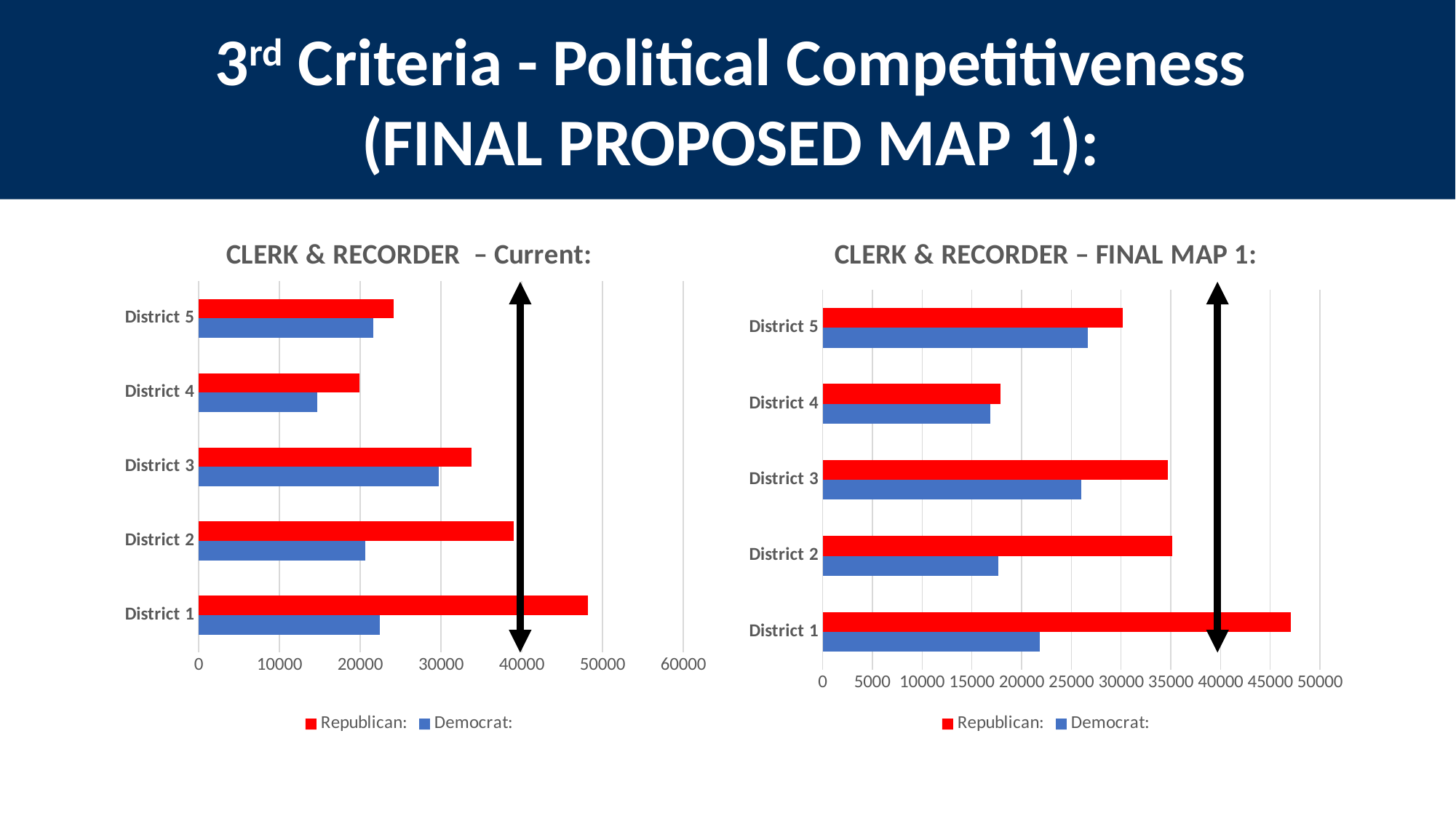
In the CLERK & RECORDER – Current chart, is the Republican value for District 1 greater or less than 40000? greater In the CLERK & RECORDER – FINAL MAP 1 chart, is the Democrat value for District 1 greater or less than 20000? greater In the CLERK & RECORDER – FINAL MAP 1 chart, which district has the highest Republican value? District 1 What kind of chart is the CLERK & RECORDER – Current chart? bar chart In the CLERK & RECORDER – Current chart, which district has the lowest Democrat value? District 4 What are the two legend entries in the CLERK & RECORDER – FINAL MAP 1 chart? Republican and Democrat In the CLERK & RECORDER – FINAL MAP 1 chart, which is larger for District 2, the Republican value or the Democrat value? Republican In the CLERK & RECORDER – Current chart, which district has the highest Republican value? District 1 How many districts are shown in the CLERK & RECORDER – Current chart? 5 How many series does the legend of the CLERK & RECORDER – Current chart list? 2 In the CLERK & RECORDER – FINAL MAP 1 chart, is the Republican value for District 4 greater or less than 20000? less